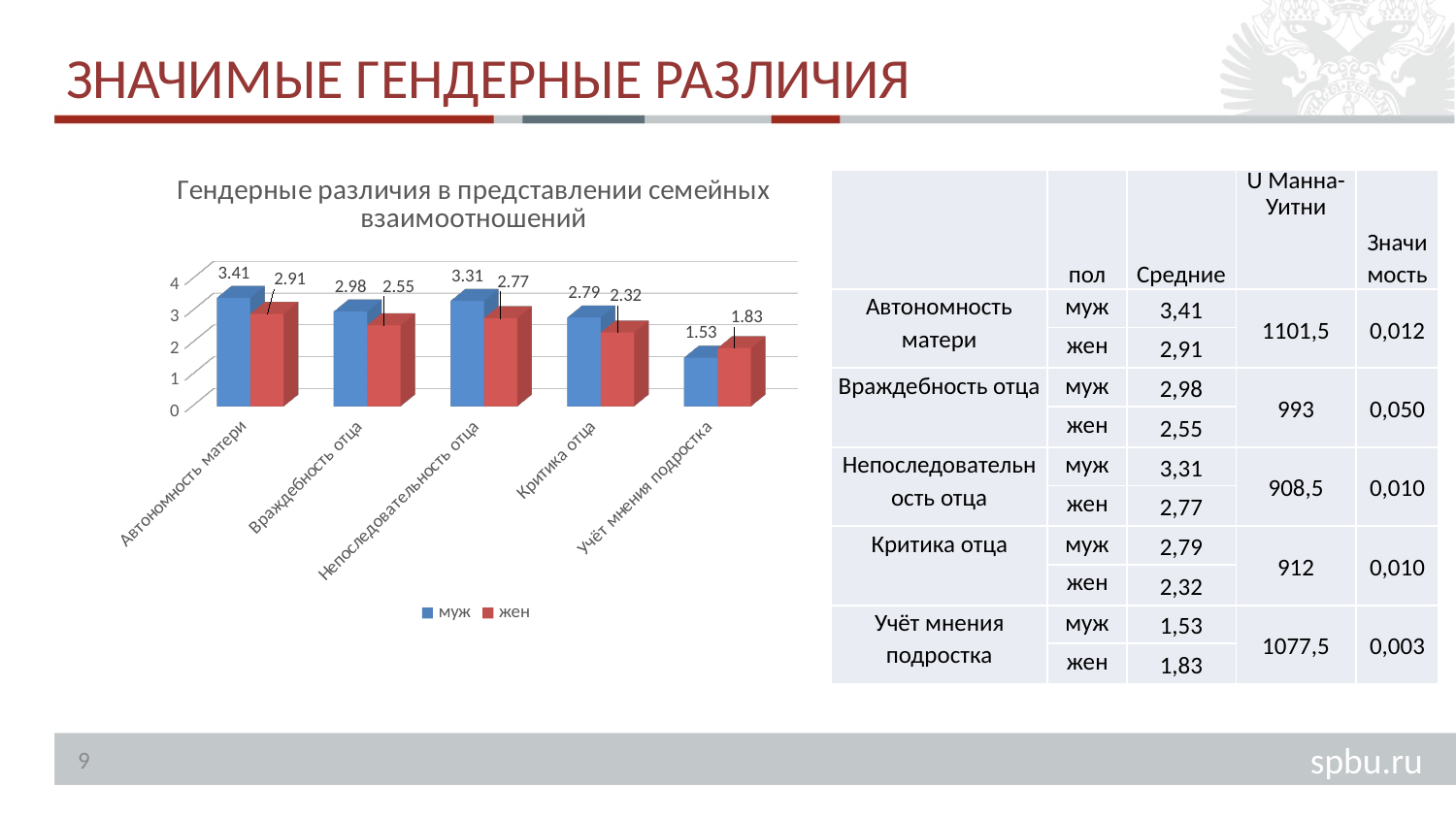
What is the difference between the муж and жен values in the Непоследовательность отца category? 0.54 In the Учёт мнения подростка category, which series has the larger value, муж or жен? жен Is the value for жен in the Враждебность отца category greater or less than 3? less What is the value for жен in the Критика отца category? 2.32 Which category has the lowest value for the жен series? Учёт мнения подростка How many series does the chart legend list? 2 What is the title of the chart? Гендерные различия в представлении семейных взаимоотношений What is the value for муж in the Автономность матери category? 3.41 What is the value for муж in the Учёт мнения подростка category? 1.53 How many categories are shown on the x axis of the chart? 5 What kind of chart is shown on the slide? bar chart Which category has the highest value for the муж series? Автономность матери